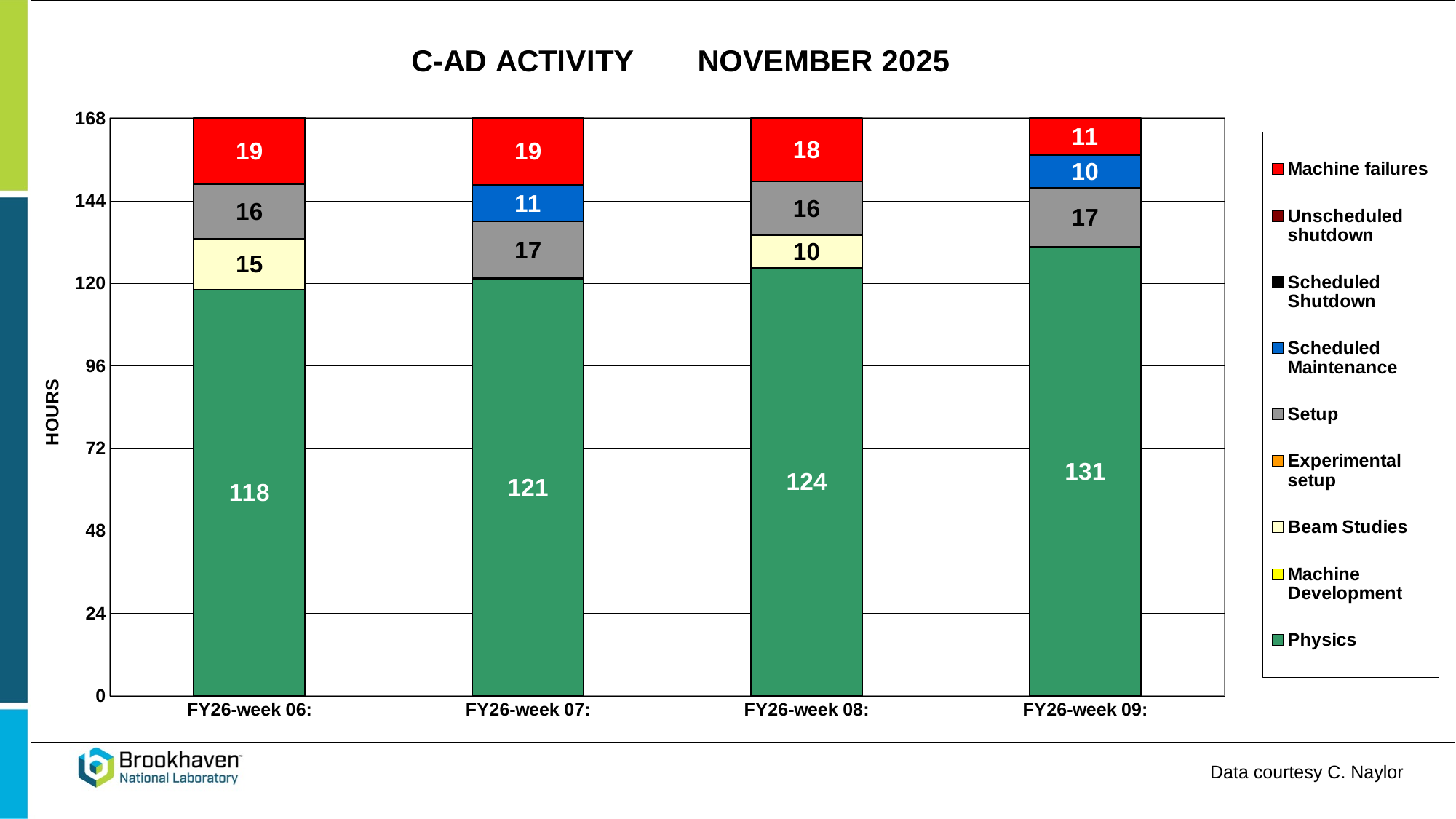
How many Beam Studies hours are shown for FY26-week 06? 15 How many Machine failures hours are shown for FY26-week 09? 11 How many series does the legend list? 9 What is the total of the stacked bar for FY26-week 07? 168 Which week has the highest Physics hours? FY26-week 09 How many weeks (categories) are shown on the x axis? 4 What is the difference in Physics hours between FY26-week 09 and FY26-week 06? 13 How many Scheduled Maintenance hours are shown for FY26-week 07? 11 Which week has the lowest Machine failures hours? FY26-week 09 How many Physics hours are shown for FY26-week 08? 124 Do Physics hours rise or fall from FY26-week 06 to FY26-week 09? Rise What kind of chart is shown on the slide? Stacked bar chart